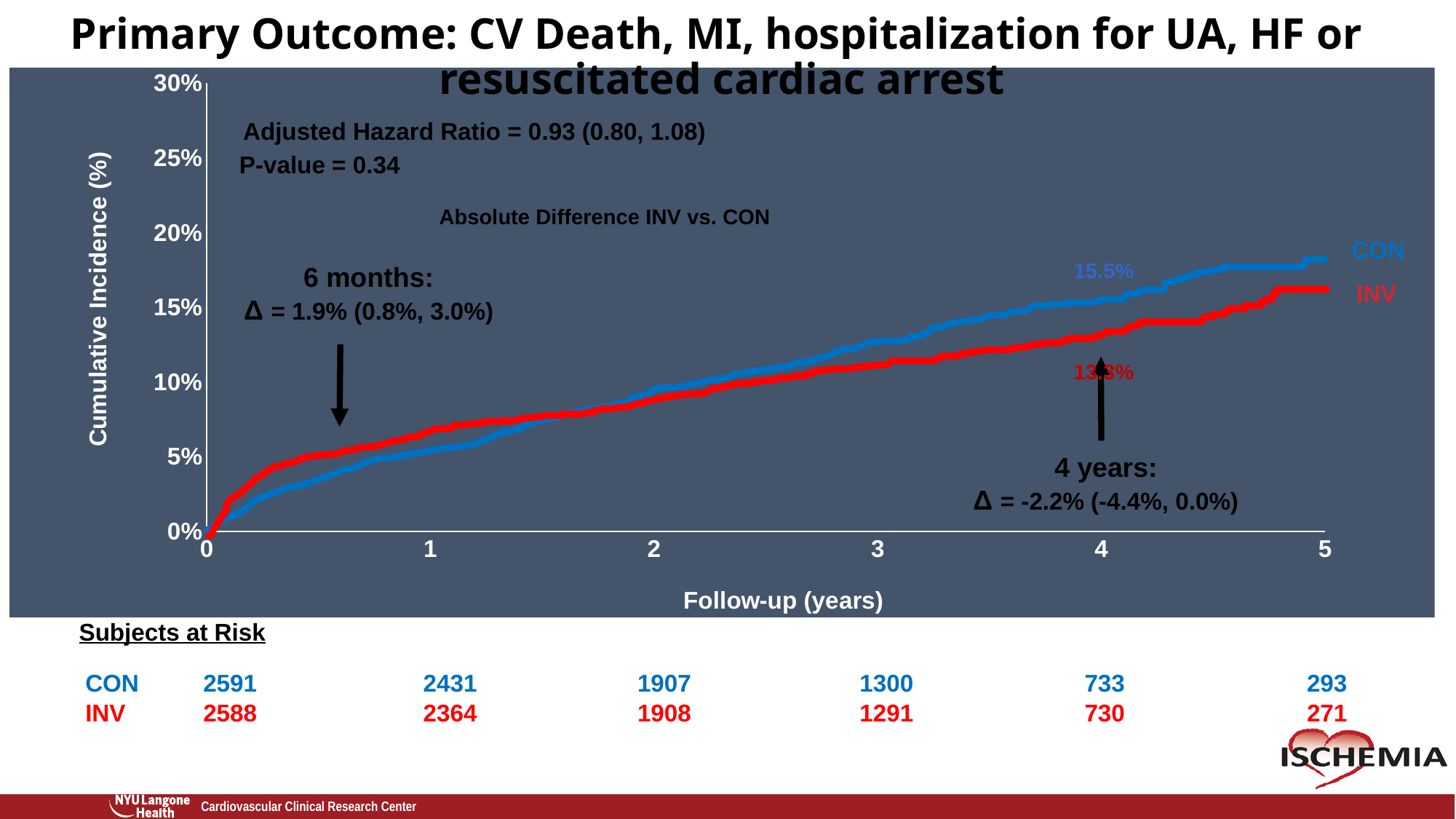
What is the absolute difference (Δ) INV vs. CON at 4 years, as annotated on the chart? -2.2% (-4.4%, 0.0%) What is the absolute difference (Δ) INV vs. CON at 6 months, as annotated on the chart? 1.9% (0.8%, 3.0%) What is the adjusted hazard ratio shown on the chart? 0.93 (0.80, 1.08) At 6 months of follow-up, which group has the higher cumulative incidence, CON or INV? INV Is the cumulative incidence for CON at 5 years greater or less than 15%? greater In the Subjects at Risk table, how many CON subjects are at risk at year 0? 2591 What kind of chart is shown on the slide? Line chart How many series (treatment groups) are plotted on the chart? 2 What is the cumulative incidence for CON at 4 years, as labelled on the chart? 15.5% At 4 years of follow-up, which group has the higher cumulative incidence, CON or INV? CON Is the cumulative incidence for INV at 1 year greater or less than 10%? less Do the cumulative incidence curves rise or fall as follow-up time increases? Rise